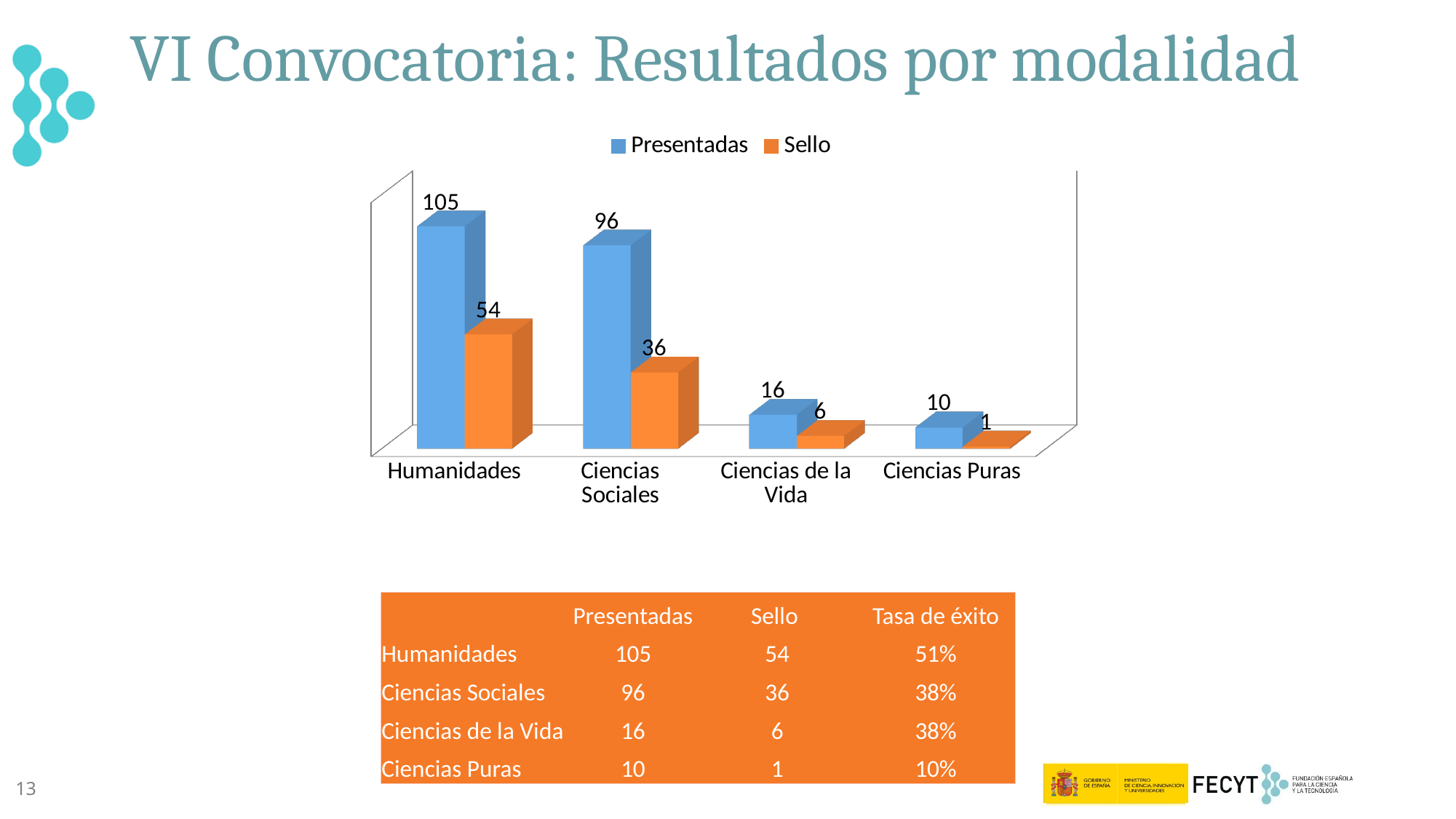
Do the Presentadas values rise or fall from left to right along the x axis? Fall Which category has the highest Presentadas value? Humanidades What is the Presentadas value for Humanidades? 105 How many series does the chart legend list? 2 How many categories are shown on the x axis of the chart? 4 What is the Sello value for Ciencias Sociales? 36 What is the difference between Presentadas and Sello for Humanidades? 51 Which is larger, the Sello value for Humanidades or the Sello value for Ciencias Sociales? Humanidades What is the Sello value for Ciencias Puras? 1 Which category has the lowest Sello value? Ciencias Puras What is the difference between the Presentadas values for Humanidades and Ciencias Sociales? 9 What kind of chart is shown on the slide? Bar chart